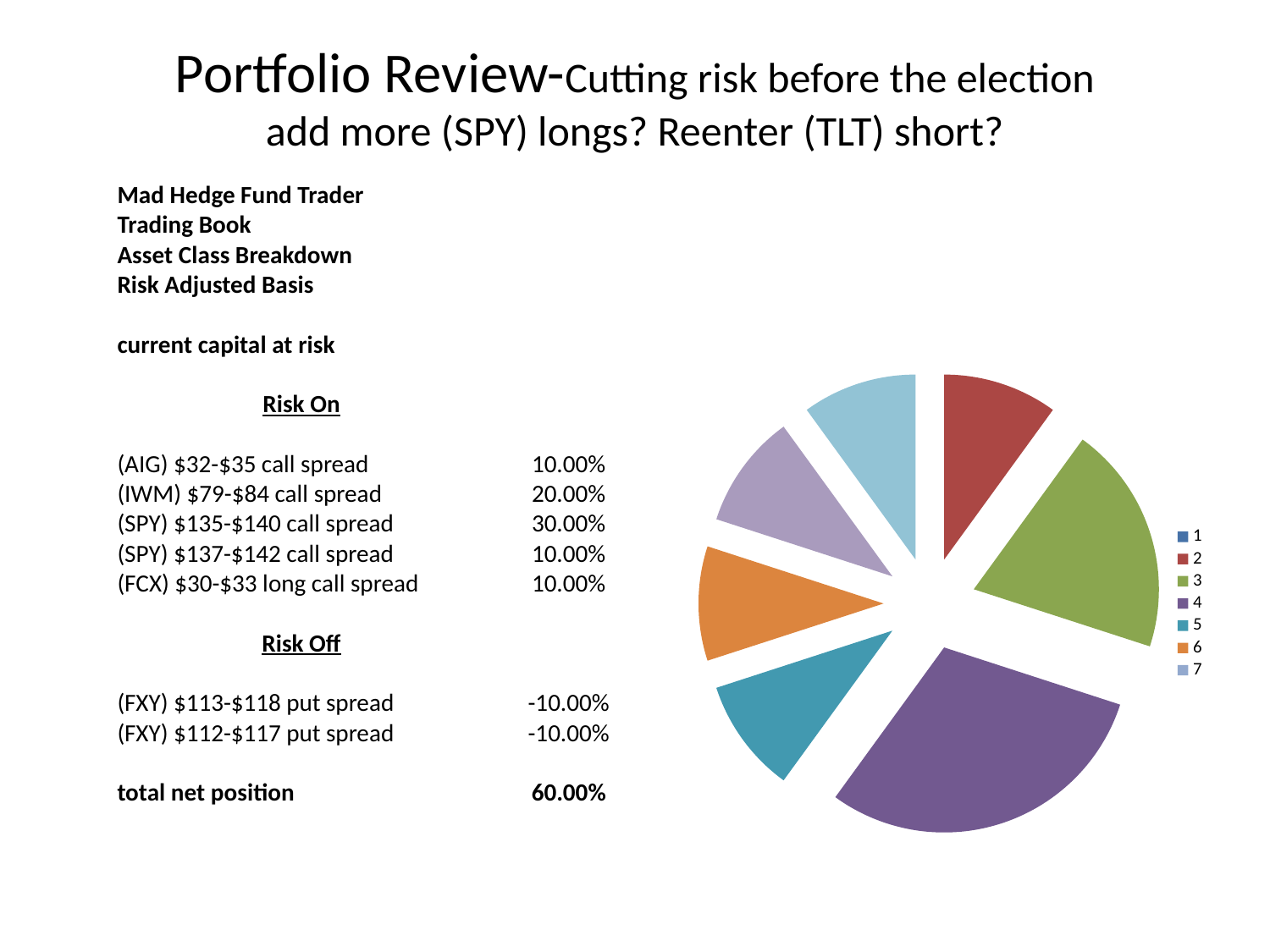
Which legend entry corresponds to the largest slice of the pie chart? 4 Which slice is larger in the pie chart, the one for legend entry 3 or the one for legend entry 6? 3 What are the labels listed in the pie chart's legend? 1, 2, 3, 4, 5, 6, 7 What kind of chart is shown on the slide? pie chart How many entries does the legend of the pie chart list? 7 Which slice is larger in the pie chart, the one for legend entry 4 or the one for legend entry 2? 4 What colour is the slice for legend entry 4 in the pie chart? purple